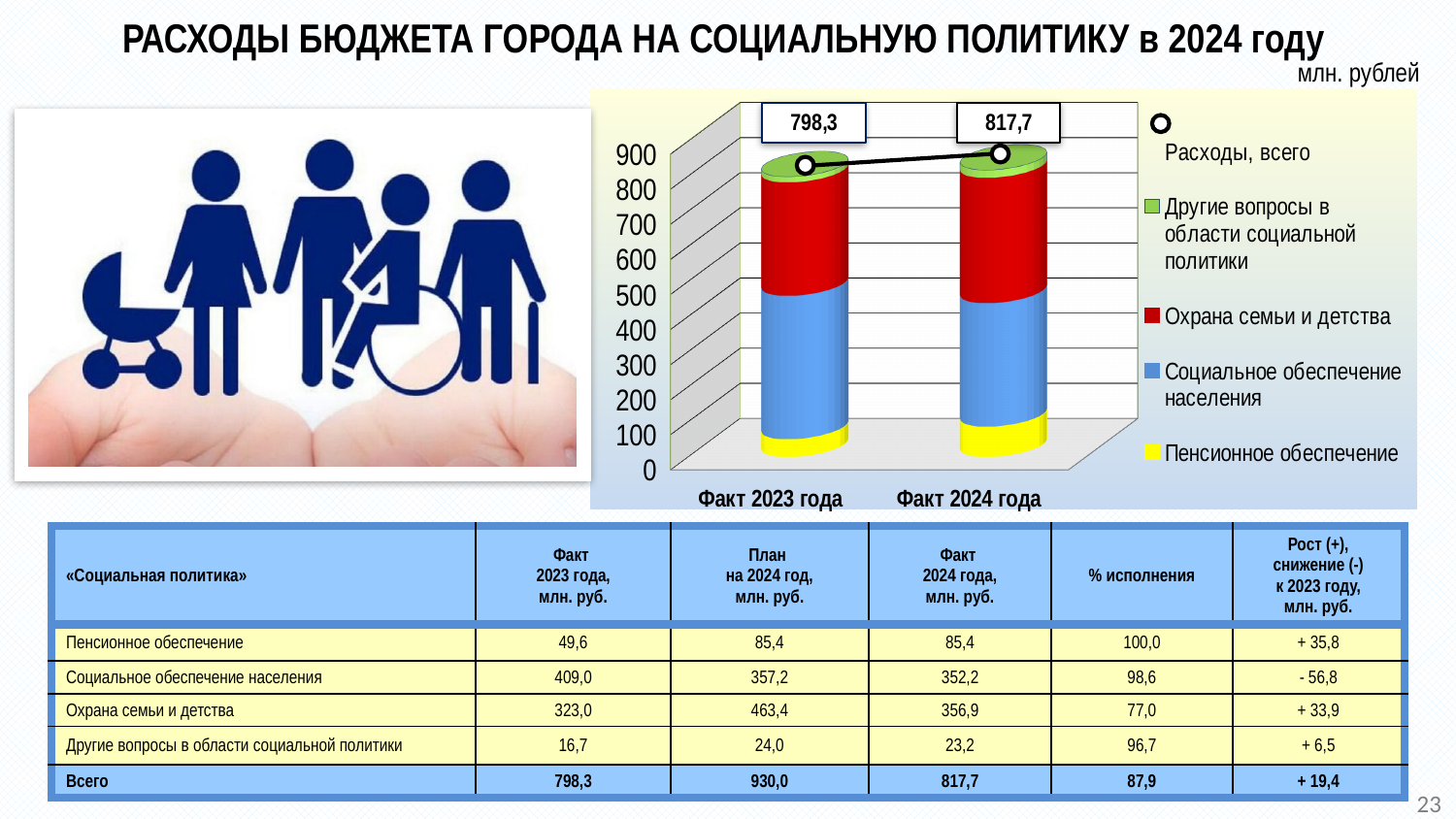
What is the value of «Расходы, всего» for Факт 2024 года? 817,7 By how much does the total expenditure for Факт 2024 года exceed that for Факт 2023 года? 19,4 Which series is shown in yellow in the chart? Пенсионное обеспечение What kind of chart is shown on the slide? Stacked bar chart with a line What is the value of «Расходы, всего» for Факт 2023 года? 798,3 How many entries does the chart legend list? 5 How many categories are shown on the x axis of the chart? 2 Which is larger, the total expenditure for Факт 2023 года or for Факт 2024 года? Факт 2024 года Does the total expenditure rise or fall from Факт 2023 года to Факт 2024 года? Rise Is the total bar height for Факт 2024 года greater or less than 900? less Is the total bar height for Факт 2023 года greater or less than 700? greater What is the highest value shown on the chart's vertical axis? 900